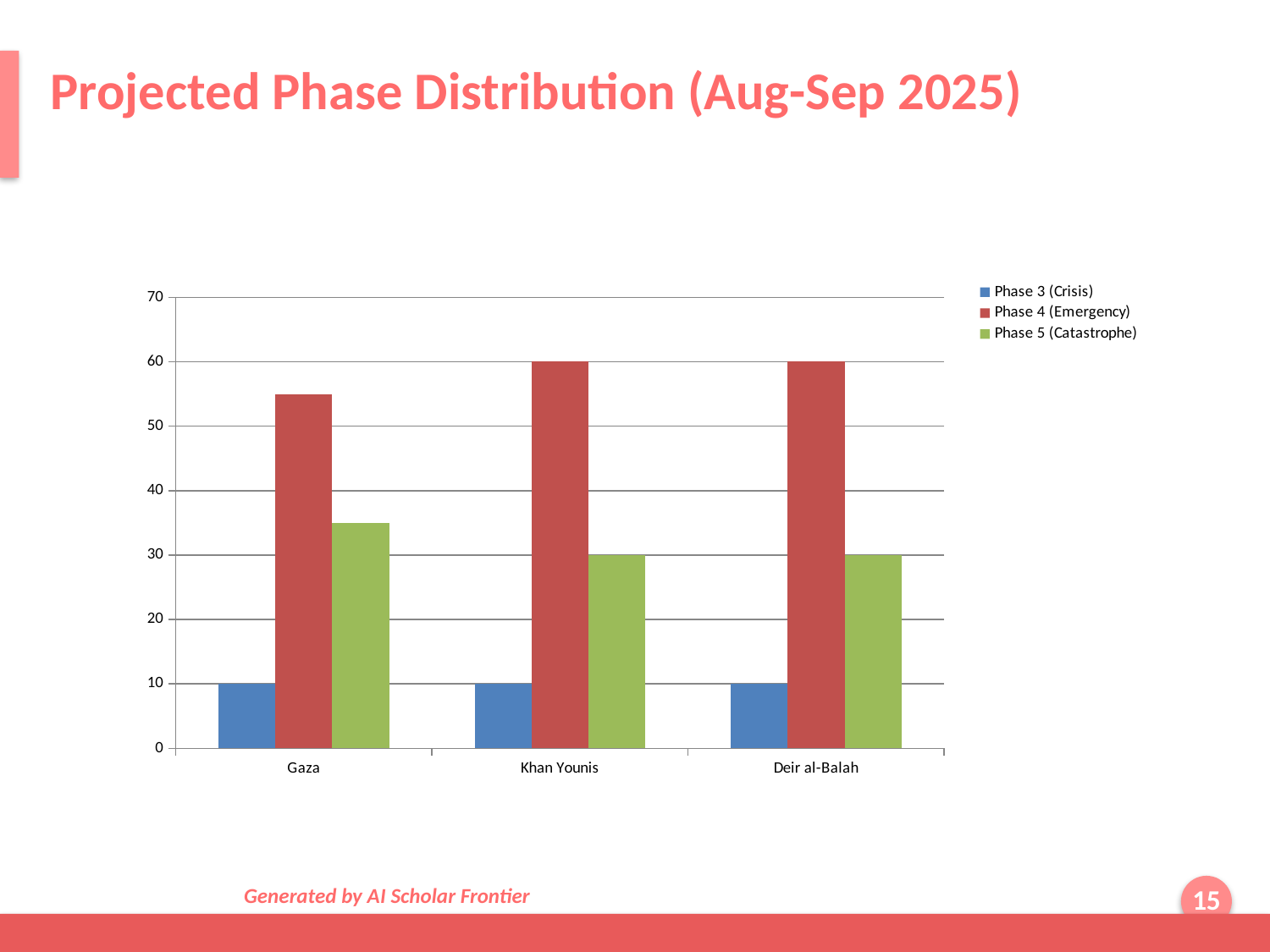
What is the difference between Phase 4 (Emergency) and Phase 5 (Catastrophe) in Khan Younis? 30 What is the value for Phase 3 (Crisis) in Gaza? 10 Which series has the highest value in Deir al-Balah? Phase 4 (Emergency) What type of chart is shown on the slide? bar chart What is the value for Phase 5 (Catastrophe) in Deir al-Balah? 30 Which is larger: Phase 5 (Catastrophe) in Gaza or Phase 5 (Catastrophe) in Khan Younis? Phase 5 (Catastrophe) in Gaza Is the value for Phase 5 (Catastrophe) in Gaza greater or less than 30? greater How many categories are shown on the x axis? 3 What is the value for Phase 4 (Emergency) in Khan Younis? 60 Is the value for Phase 4 (Emergency) in Gaza greater or less than 50? greater Which series has the lowest value in Khan Younis? Phase 3 (Crisis) How many series does the legend list? 3